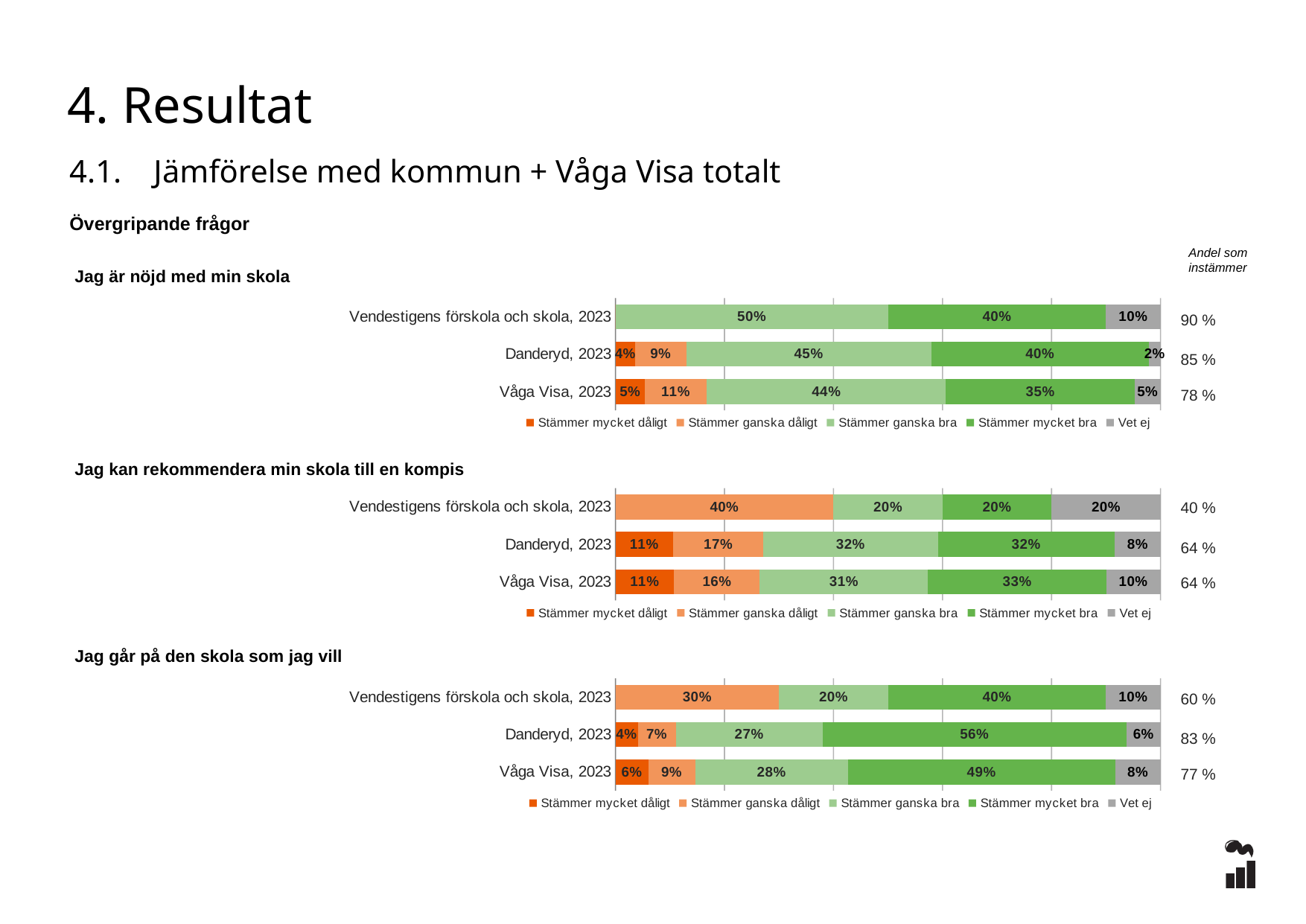
In the chart "Jag är nöjd med min skola", which row has the highest "Andel som instämmer"? Vendestigens förskola och skola, 2023 In the chart "Jag går på den skola som jag vill", what is the difference between the "Stämmer mycket bra" values for Danderyd, 2023 and Våga Visa, 2023? 7% What kind of chart is "Jag går på den skola som jag vill"? Stacked bar chart How many bars are shown in the chart "Jag kan rekommendera min skola till en kompis"? 3 In the chart "Jag kan rekommendera min skola till en kompis", which row has the lowest "Andel som instämmer"? Vendestigens förskola och skola, 2023 How many series does the legend list in the chart "Jag är nöjd med min skola"? 5 In the chart "Jag kan rekommendera min skola till en kompis", what is the "Vet ej" value for Danderyd, 2023? 8% In the chart "Jag är nöjd med min skola", what is the "Stämmer mycket bra" value for Våga Visa, 2023? 35% In the chart "Jag kan rekommendera min skola till en kompis", what is the "Stämmer ganska dåligt" value for Vendestigens förskola och skola, 2023? 40% In the chart "Jag går på den skola som jag vill", which is larger: the "Stämmer ganska dåligt" value for Vendestigens förskola och skola, 2023 or for Våga Visa, 2023? Vendestigens förskola och skola, 2023 In the chart "Jag går på den skola som jag vill", what is the "Stämmer mycket bra" value for Danderyd, 2023? 56% In the chart "Jag är nöjd med min skola", what is the "Stämmer ganska bra" value for Vendestigens förskola och skola, 2023? 50%